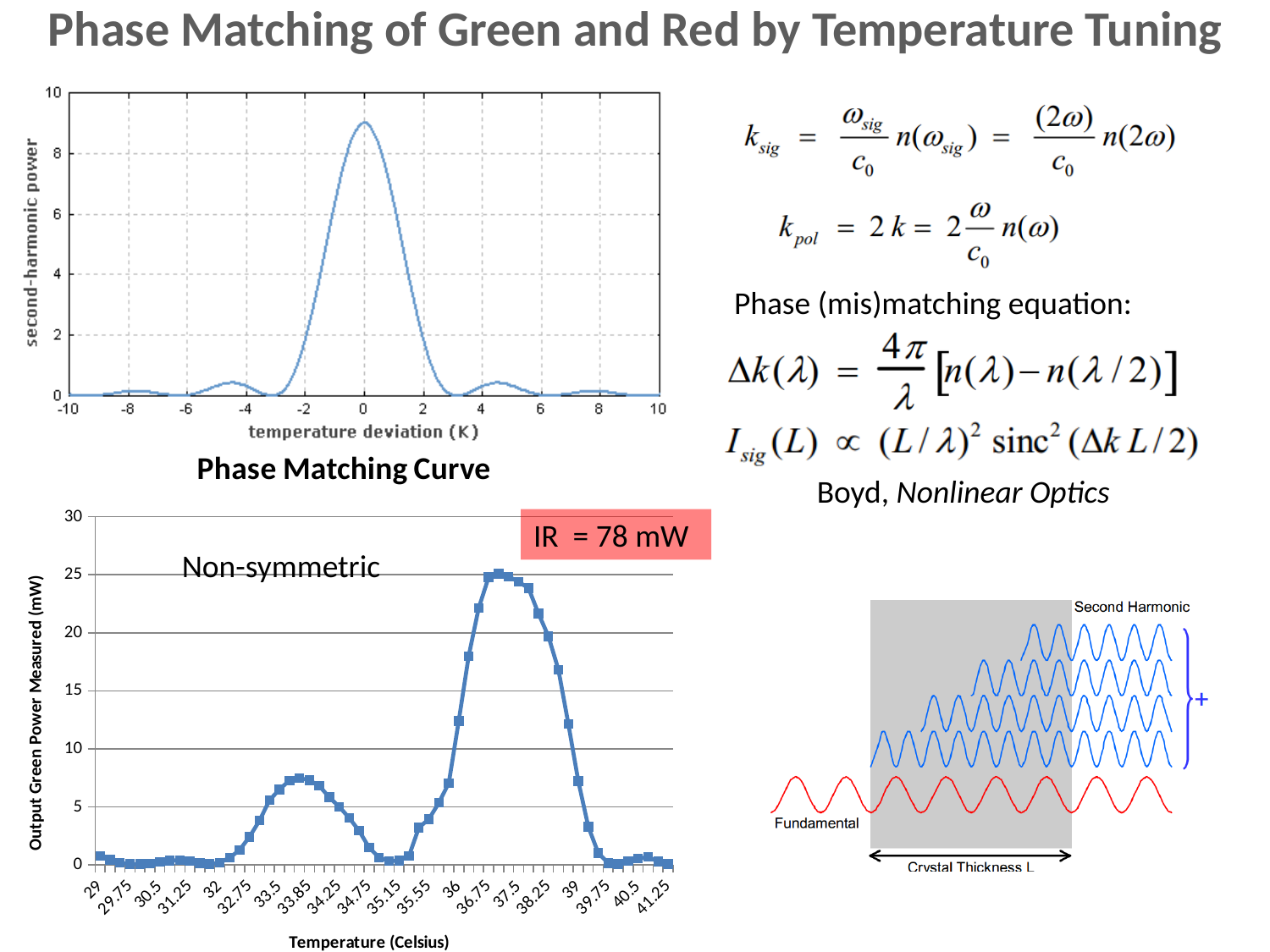
In the Phase Matching Curve chart, is the second-harmonic power at a temperature deviation of -4 K greater or less than 2? less In the Phase Matching Curve chart, at which temperature deviation (K) is the second-harmonic power highest? 0 In the bottom-left chart, which temperature has the larger output green power, 33.85 °C or 37.5 °C? 37.5 °C In the bottom-left chart, is the output green power at 33.85 °C greater or less than 10 mW? less What kind of chart is the bottom-left chart of Output Green Power Measured versus Temperature? line chart In the Phase Matching Curve chart, is the second-harmonic power at a temperature deviation of 0 K greater or less than 8? greater What is the y-axis title of the bottom-left chart? Output Green Power Measured (mW) What kind of chart is the Phase Matching Curve chart at the top left? line chart In the bottom-left chart, which temperature has the larger output green power, 33.85 °C or 35.15 °C? 33.85 °C What IR power is stated in the annotation box on the bottom-left chart? IR = 78 mW